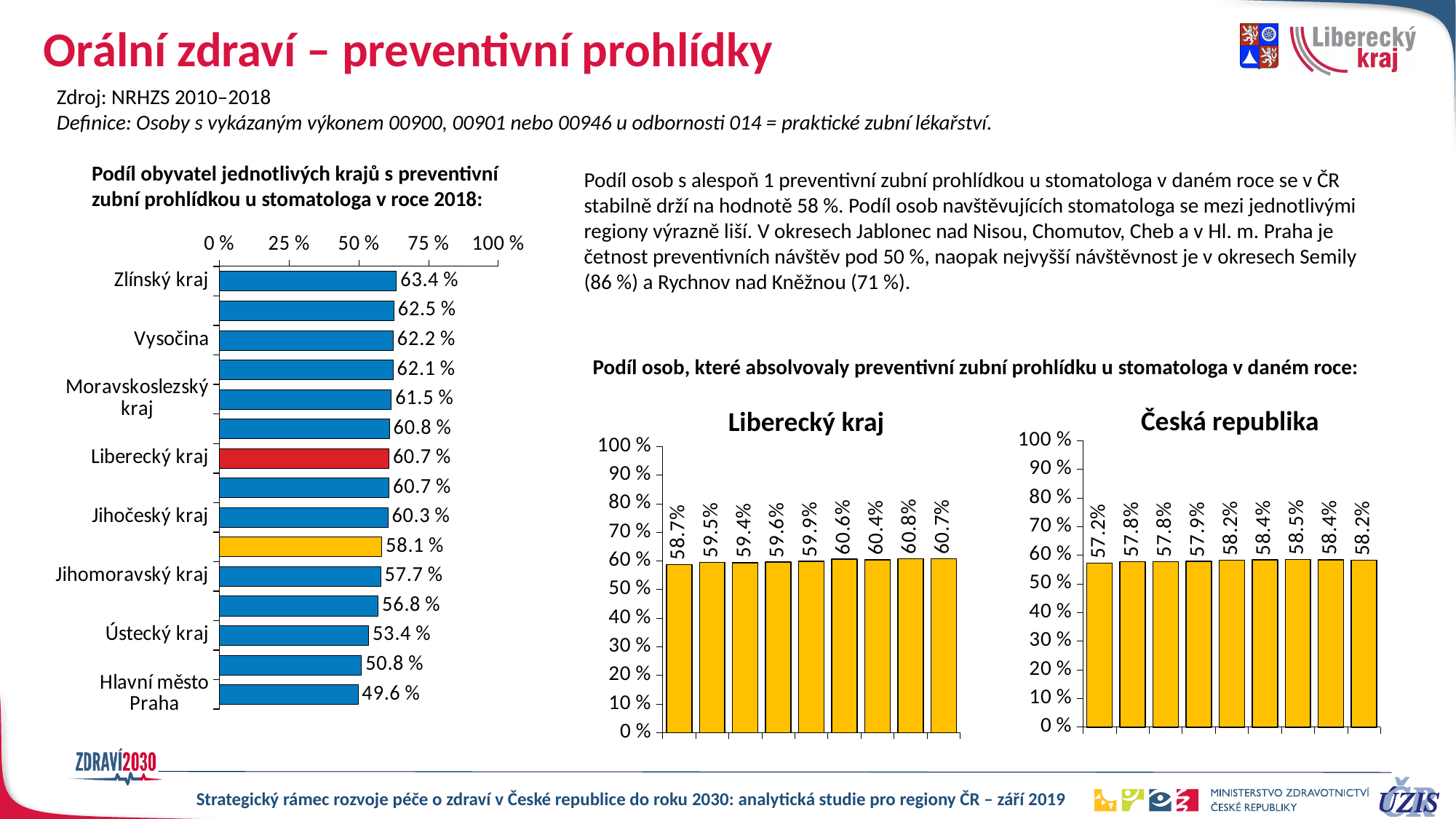
In the Liberecký kraj chart, what is the highest value shown? 60.8% In the left chart (Podíl obyvatel jednotlivých krajů ... v roce 2018), which region has the highest value? Zlínský kraj In the left chart (Podíl obyvatel jednotlivých krajů ... v roce 2018), which region has the lowest value? Hlavní město Praha In the left chart (Podíl obyvatel jednotlivých krajů ... v roce 2018), what is the value for Zlínský kraj? 63.4 % In the left chart (Podíl obyvatel jednotlivých krajů ... v roce 2018), what is the difference between the values for Zlínský kraj and Hlavní město Praha? 13.8 % In the left chart (Podíl obyvatel jednotlivých krajů ... v roce 2018), what colour is the bar for Liberecký kraj? Red In the left chart (Podíl obyvatel jednotlivých krajů ... v roce 2018), what is the value for Hlavní město Praha? 49.6 % In the left chart (Podíl obyvatel jednotlivých krajů ... v roce 2018), what is the value for Liberecký kraj? 60.7 % In the Česká republika chart, what is the lowest value shown? 57.2% In the left chart (Podíl obyvatel jednotlivých krajů ... v roce 2018), how many bars are plotted? 15 In the Liberecký kraj chart, what is the value of the first (leftmost) bar? 58.7% In the left chart (Podíl obyvatel jednotlivých krajů ... v roce 2018), which has the larger value, Vysočina or Jihočeský kraj? Vysočina